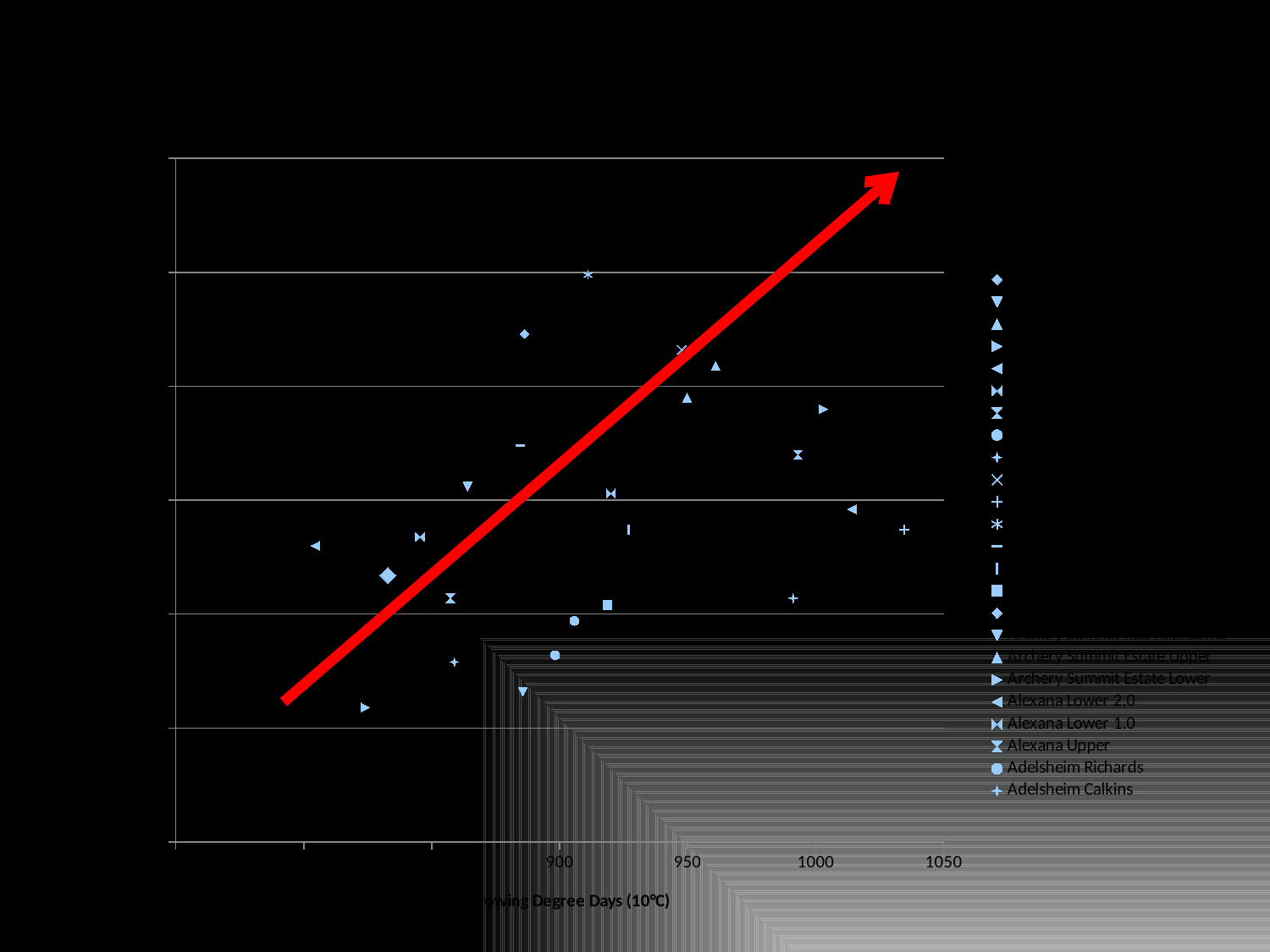
Is the x value of the lowest plotted point greater or less than 850? less What kind of chart is shown on the slide? scatter chart Which legend entry is listed last, at the bottom of the legend? Adelsheim Calkins Is the x value of the leftmost plotted point greater or less than 850? less According to the red arrow, do the plotted values rise or fall as Growing Degree Days increase along the x axis? rise What is the largest tick label shown on the x axis? 1050 Is the x value of the rightmost plotted point greater or less than 1000? greater